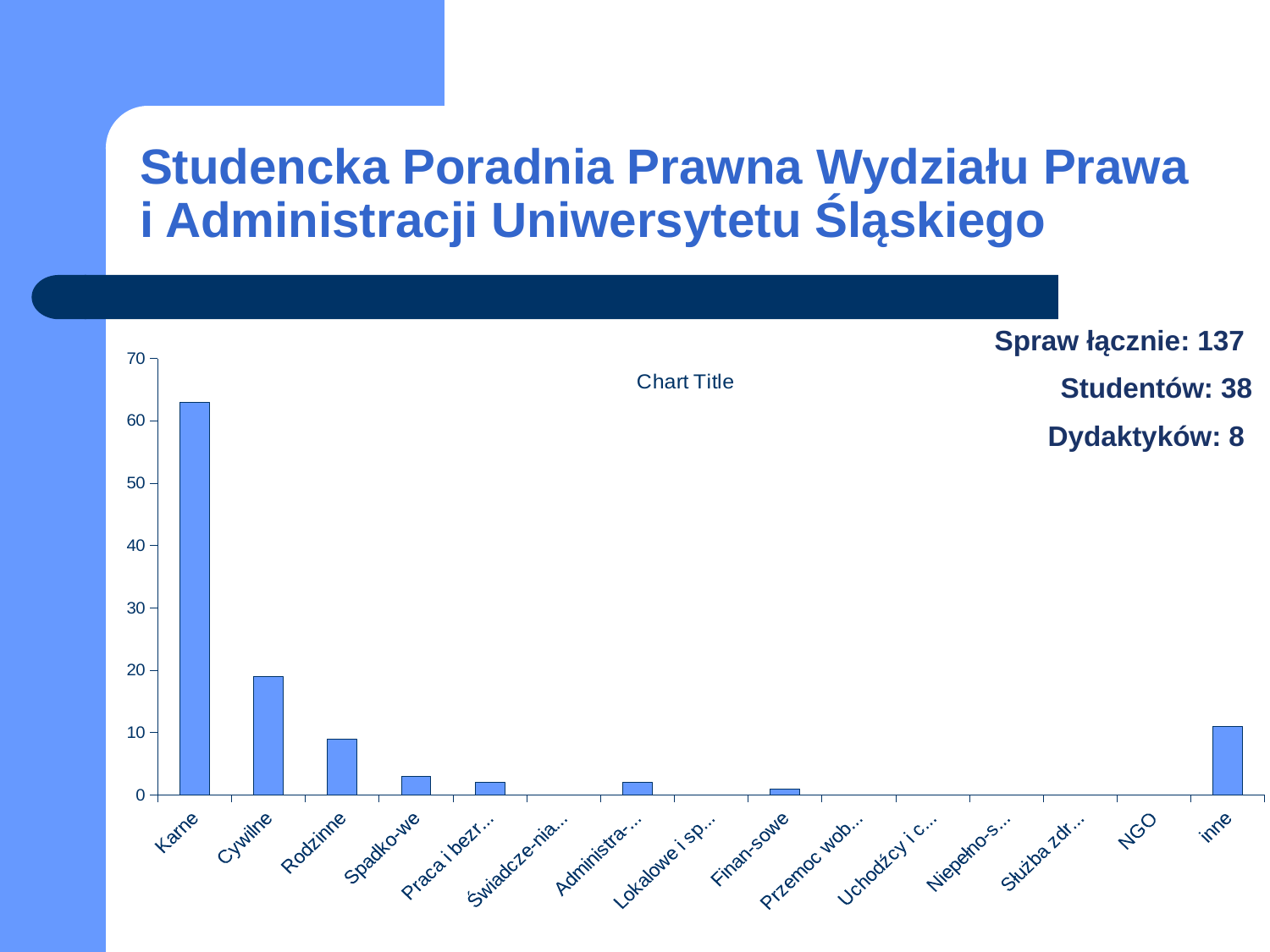
What kind of chart is shown on the slide? bar chart Which is larger, the value for Cywilne or the value for inne? Cywilne How many categories are shown on the x axis of the chart? 15 Is the value for Cywilne greater or less than 10? greater Which is larger, the value for Karne or the value for Cywilne? Karne Which category has the highest bar in the chart? Karne What title is displayed on the chart? Chart Title Which is larger, the value for Spadko-we or the value for NGO? Spadko-we Is the value for Karne greater or less than 60? greater